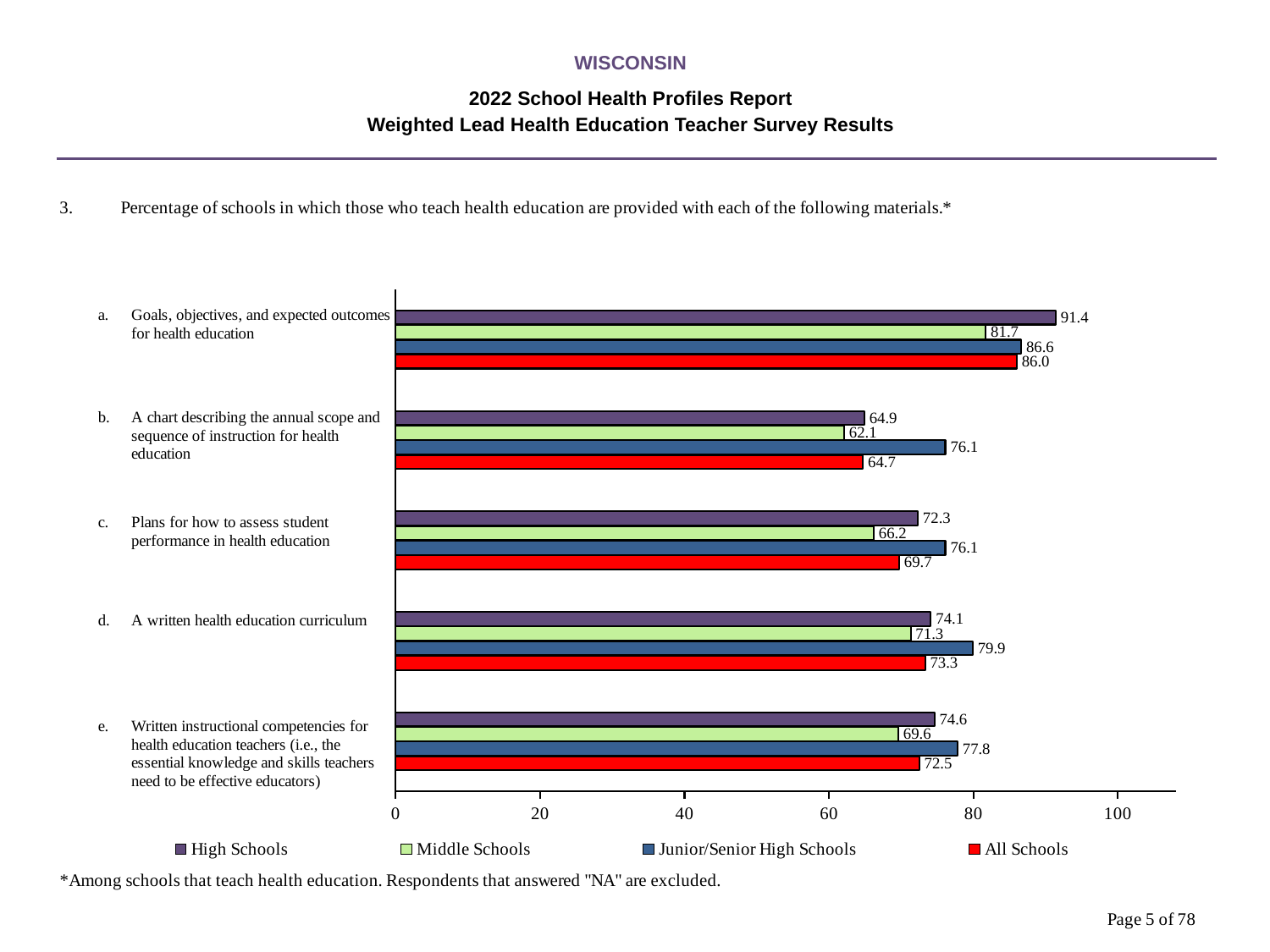
How many series does the legend list? 4 What is the value for Middle Schools for item b, a chart describing the annual scope and sequence of instruction for health education? 62.1 What is the value for Junior/Senior High Schools for item d, a written health education curriculum? 79.9 Is the All Schools value for item b, a chart describing the annual scope and sequence of instruction, greater or less than 80? less What kind of chart is shown on the slide? Bar chart What is the value for High Schools for item a, goals, objectives, and expected outcomes for health education? 91.4 What is the difference between the High Schools and Middle Schools values for item a, goals, objectives, and expected outcomes for health education? 9.7 How many items (categories) are shown on the chart? 5 For item c, plans for how to assess student performance in health education, which is larger: the High Schools value or the Junior/Senior High Schools value? Junior/Senior High Schools What is the All Schools value for item e, written instructional competencies for health education teachers? 72.5 Which item has the highest All Schools value? Goals, objectives, and expected outcomes for health education Which item has the lowest Middle Schools value? A chart describing the annual scope and sequence of instruction for health education